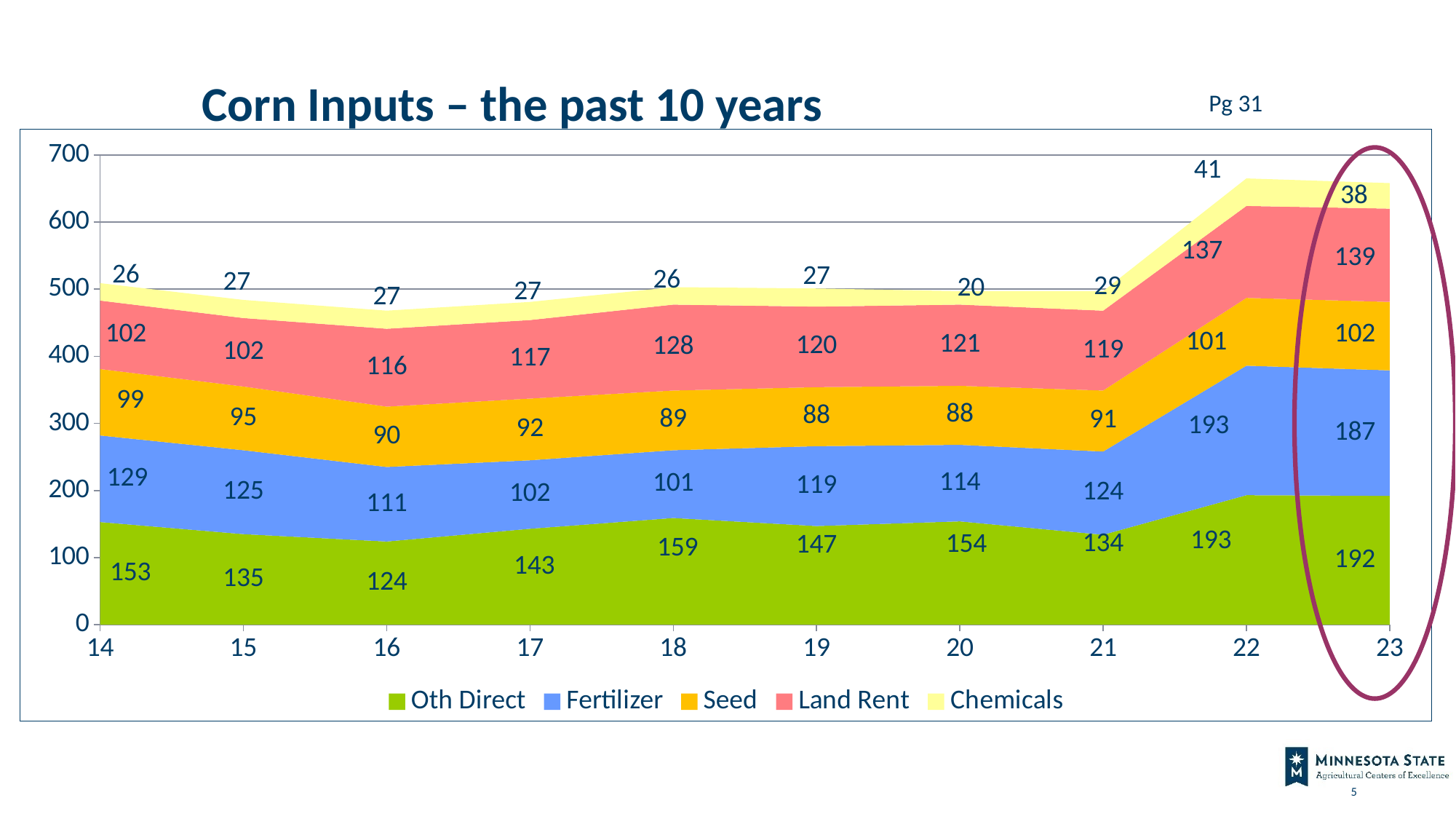
How many series does the legend list? 5 What kind of chart is shown on the slide? Stacked area chart What is the Land Rent value for year 18? 128 Which colour represents Land Rent in the chart? Red (pink) What is the Chemicals value for year 22? 41 What is the total of all five inputs for year 23? 658 How many years are shown on the x axis? 10 In which year is the Oth Direct value lowest? 16 What is the Fertilizer value for year 23? 187 In which year is the Fertilizer value highest? 22 Which is larger, the Seed value for year 14 or the Seed value for year 19? Seed value for year 14 What is the difference between the Fertilizer values for year 22 and year 21? 69